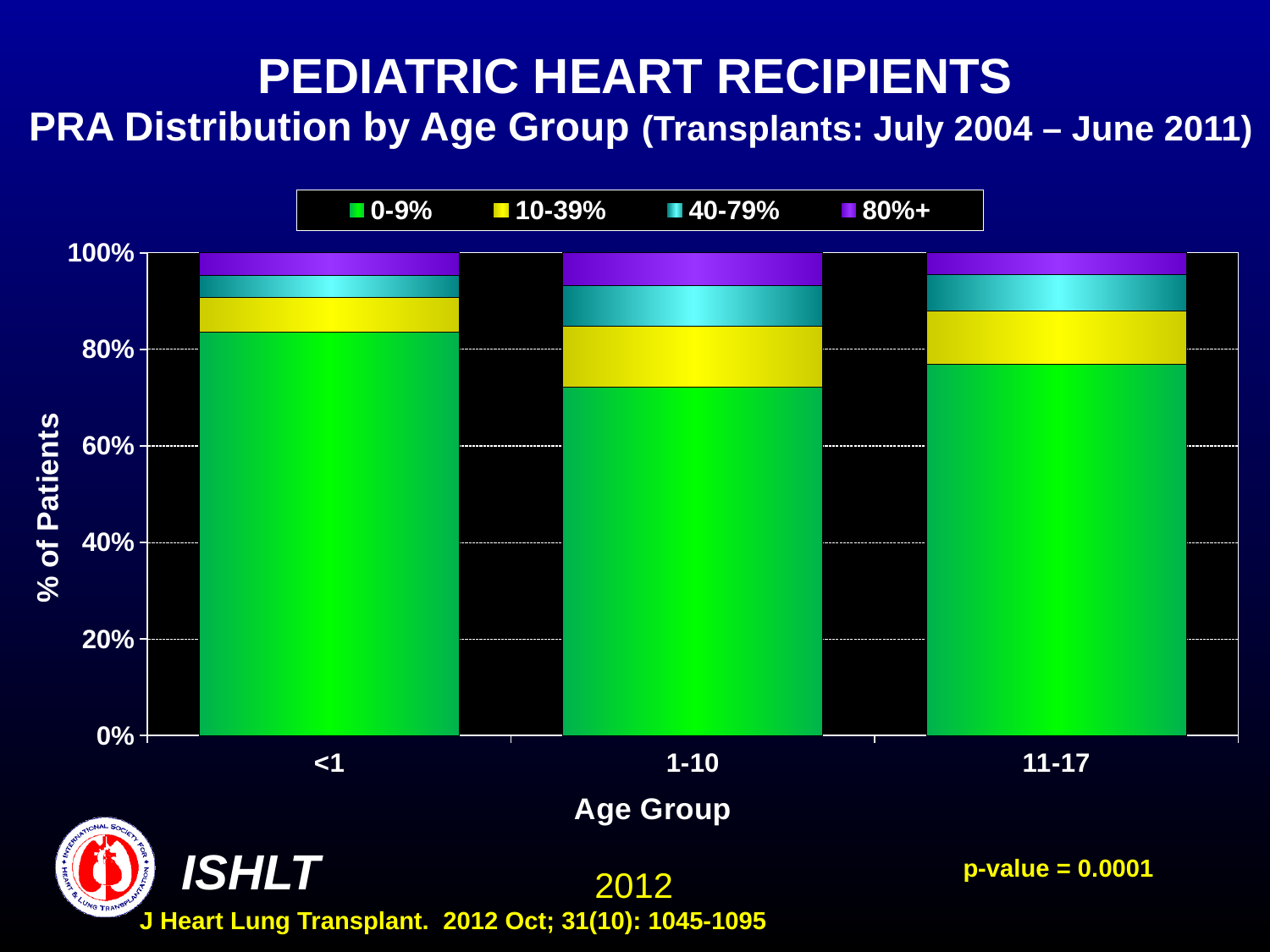
What is the label of the y axis? % of Patients Is the value of the 0-9% segment for the 1-10 age group greater or less than 80%? less How many age groups are shown on the x axis? 3 Which age group has a larger 10-39% segment, <1 or 1-10? 1-10 Is the value of the 0-9% segment for the <1 age group greater or less than 80%? greater Is the value of the 0-9% segment for the 11-17 age group greater or less than 80%? less Which age group has the smallest 0-9% segment? 1-10 What is the total height of the stacked bar for the 1-10 age group? 100% What p-value is shown on the slide? 0.0001 Which age group has the largest 0-9% segment? <1 How many series does the legend list? 4 What type of chart is shown on the slide? stacked bar chart